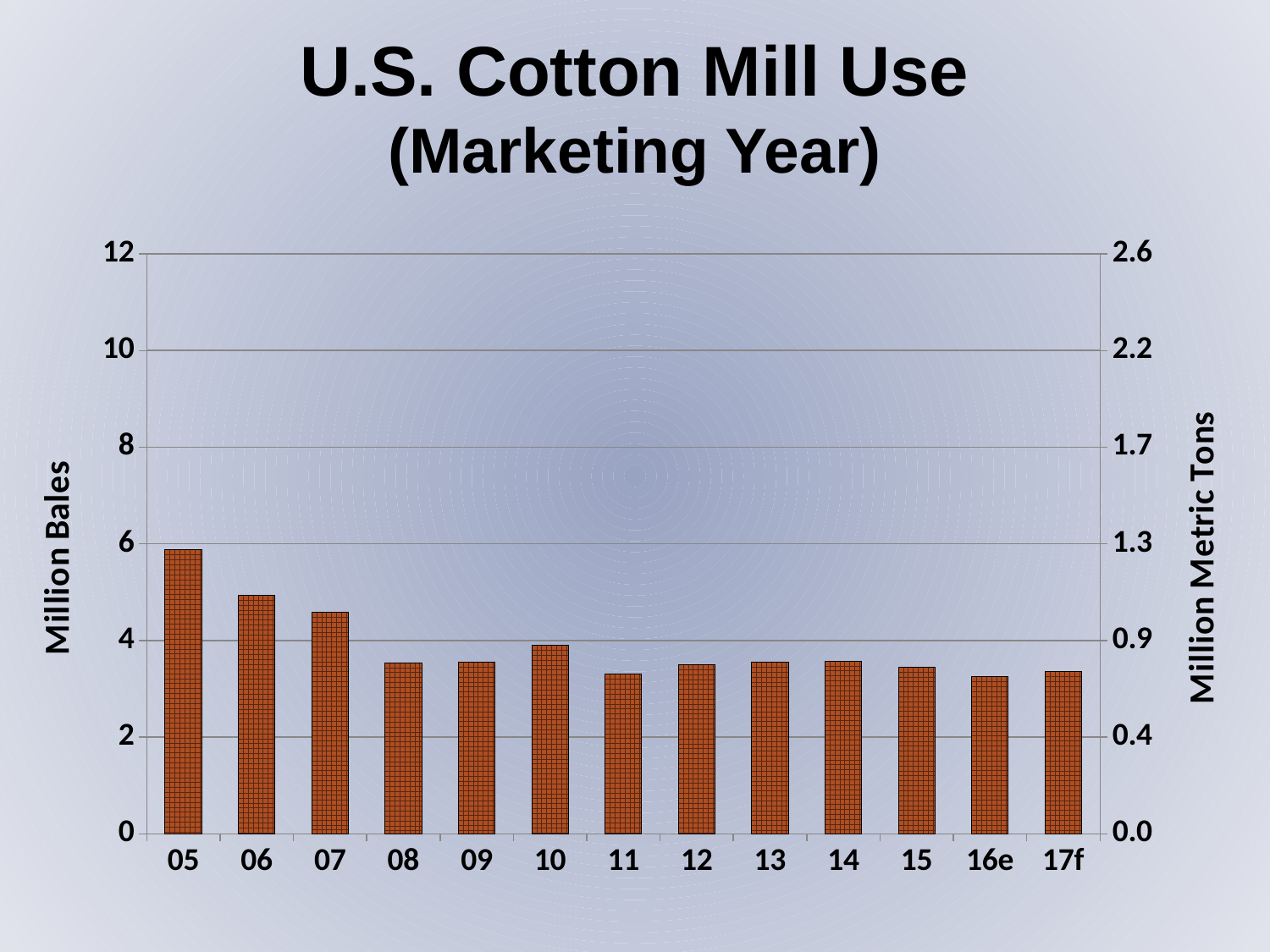
Is the value for 05 greater or less than 4 million bales? greater What kind of chart is shown on the slide? bar chart Is the value for 08 greater or less than 4 million bales? less Which is larger, the value for 05 or the value for 06? 05 Do the values rise or fall from 05 to 08? fall What is the title of the left vertical axis? Million Bales Which marketing year has the highest U.S. cotton mill use? 05 Which is larger, the value for 10 or the value for 11? 10 Is the value for 16e greater or less than 2 million bales? greater How many marketing years are shown on the x axis of the chart? 13 What is the title of the right vertical axis? Million Metric Tons